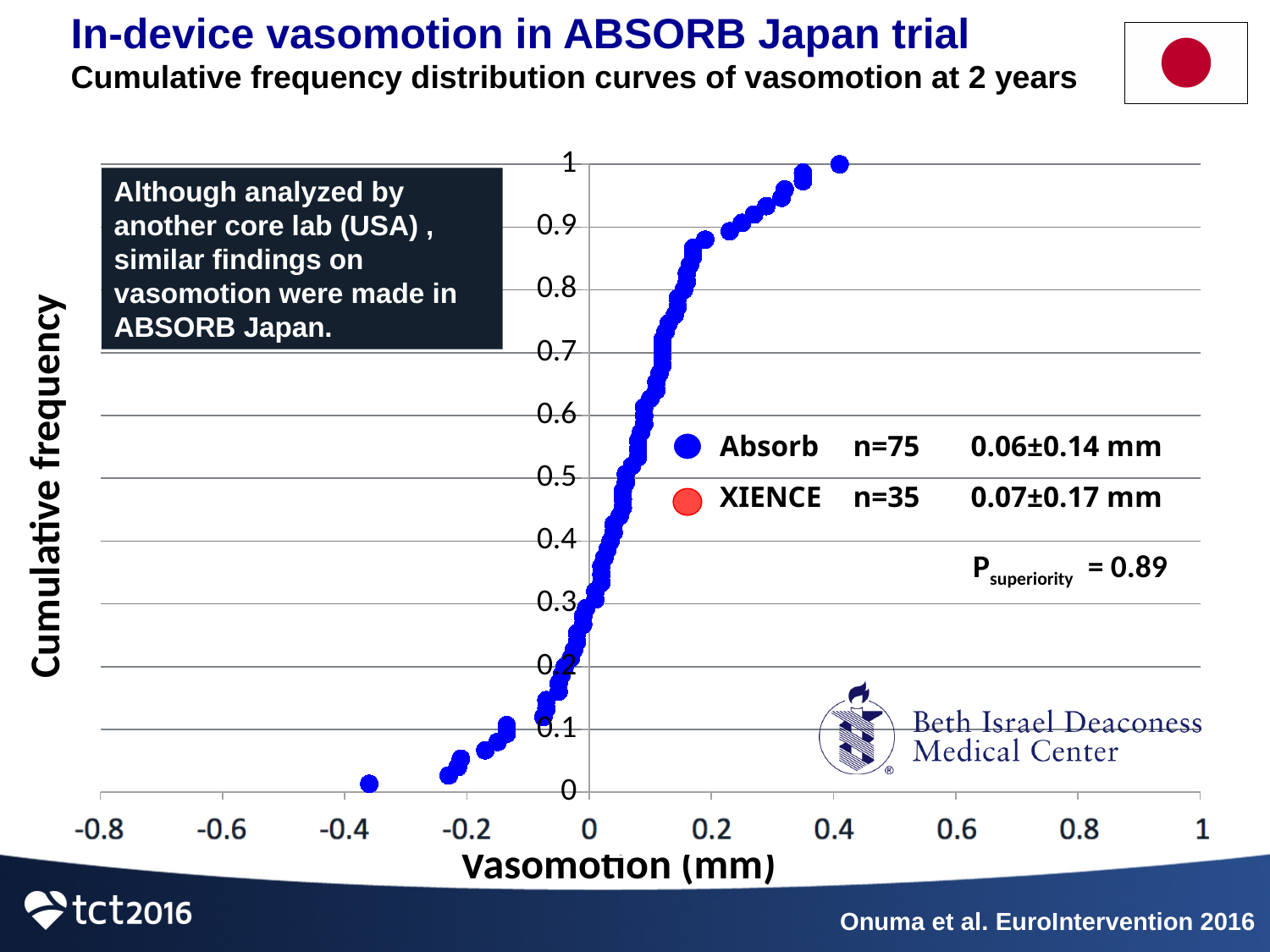
What are the two series named in the chart legend? Absorb and XIENCE Does the cumulative frequency of the Absorb curve rise or fall as vasomotion increases along the x axis? rise What is the P superiority value shown on the chart? 0.89 What is the label of the x axis of the chart? Vasomotion (mm) What is the n value shown for XIENCE in the legend? n=35 What vasomotion value (mean ± SD) is shown for XIENCE? 0.07±0.17 mm Which series has the larger number of patients (n), Absorb or XIENCE? Absorb How many series does the chart legend list? 2 What vasomotion value (mean ± SD) is shown for Absorb? 0.06±0.14 mm What is the difference between the n values of Absorb and XIENCE? 40 What kind of chart is shown on the slide? scatter chart What is the n value shown for Absorb in the legend? n=75